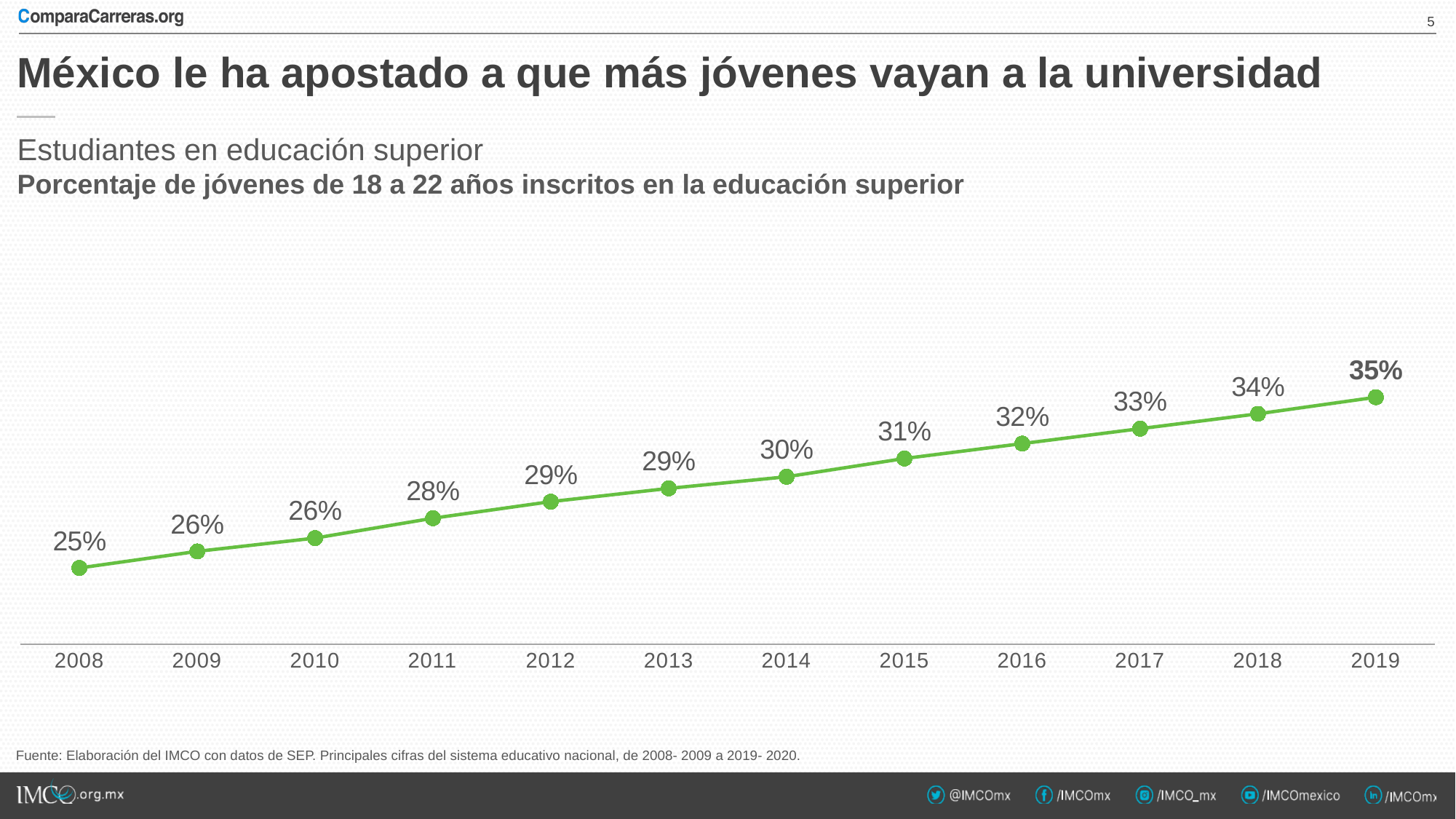
By how many percentage points did the value increase from 2008 to 2019? 10 percentage points What is the value shown for 2019? 35% How many years are plotted on the chart? 12 What percentage of young people aged 18 to 22 were enrolled in higher education in 2008? 25% What is the value shown for 2011? 28% Do the values rise or fall from 2008 to 2019? Rise Which year has the highest percentage? 2019 Which is larger, the value for 2017 or the value for 2013? 2017 What kind of chart is shown on the slide? Line chart What is the value shown for 2014? 30% What is the difference between the values for 2016 and 2012? 3 percentage points Which year has the lowest percentage? 2008